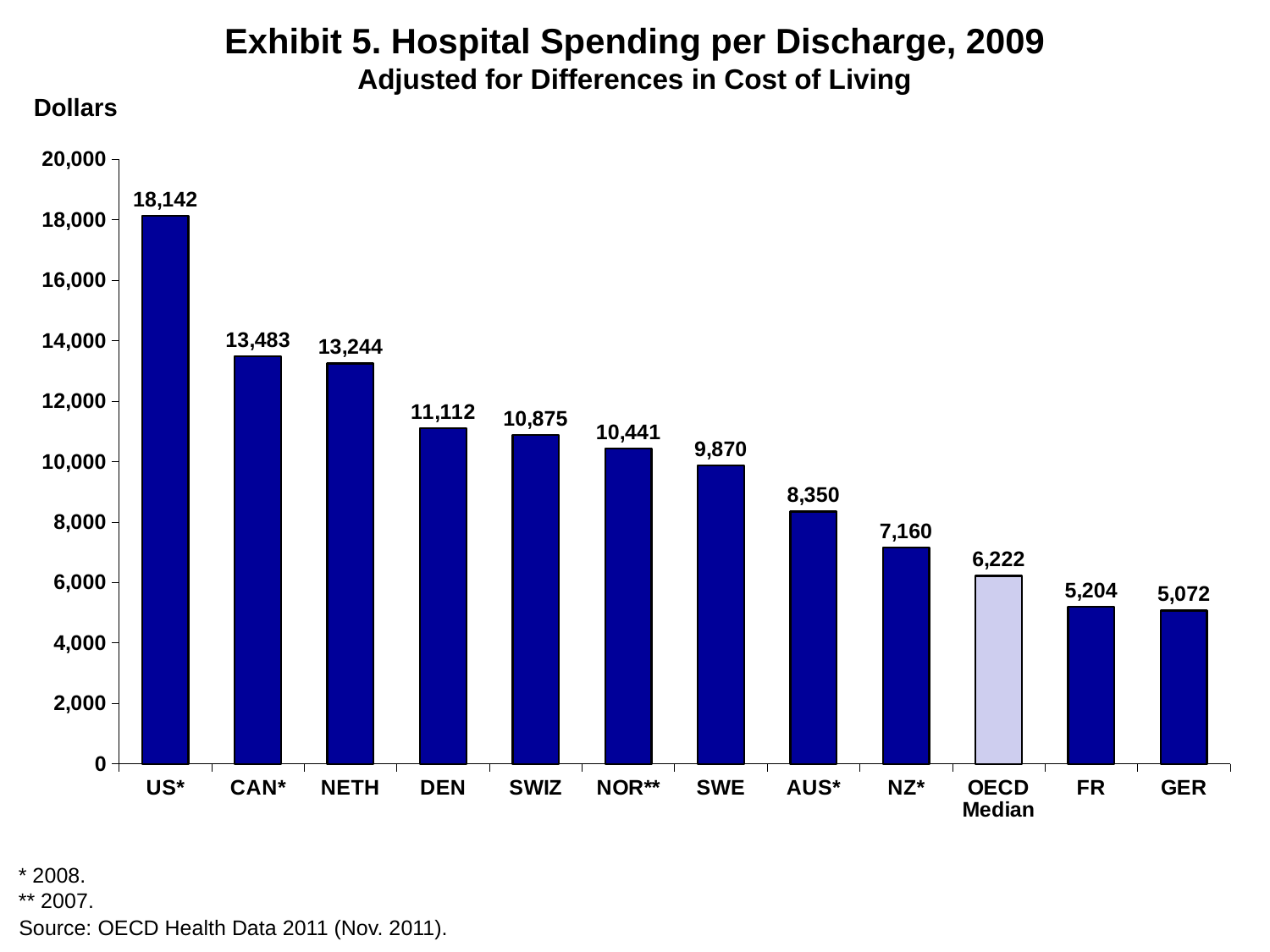
Which is larger, the value for DEN or the value for SWIZ? DEN Which country has the highest hospital spending per discharge? US* Which category has the lowest value on the chart? GER What is the hospital spending per discharge for the US*? 18,142 How many bars are shown on the chart? 12 What is the value shown for the OECD Median? 6,222 What is the difference between the values for CAN* and NETH? 239 What is the difference between the US* value and the OECD Median? 11,920 What type of chart is shown on the slide? Bar chart Do the values rise or fall from left to right across the chart? Fall Is the value for AUS* greater or less than 8,000? greater What is the hospital spending per discharge for SWE? 9,870